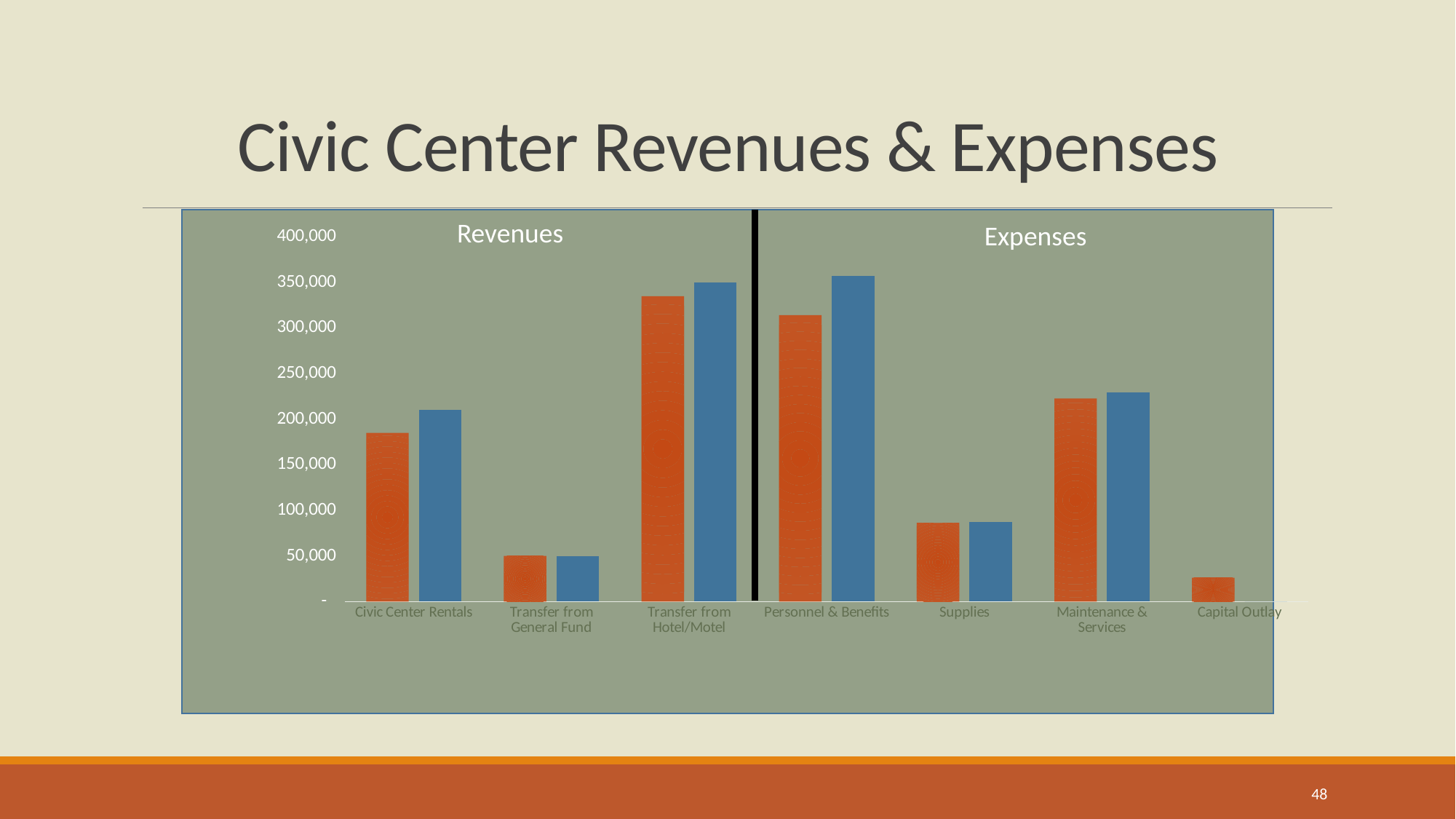
Is the value of the orange bar for Capital Outlay greater or less than 50,000? less What are the two section labels printed inside the chart area? Revenues and Expenses Is the value of the blue bar for Civic Center Rentals greater or less than 200,000? greater Is the value of the orange bar for Civic Center Rentals greater or less than 200,000? less Which category has the tallest bar in the chart? Personnel & Benefits Which category has larger values, Civic Center Rentals or Supplies? Civic Center Rentals What kind of chart is shown on the slide? bar chart Which category has the shortest bars in the chart? Capital Outlay How many categories are shown along the x axis of the chart? 7